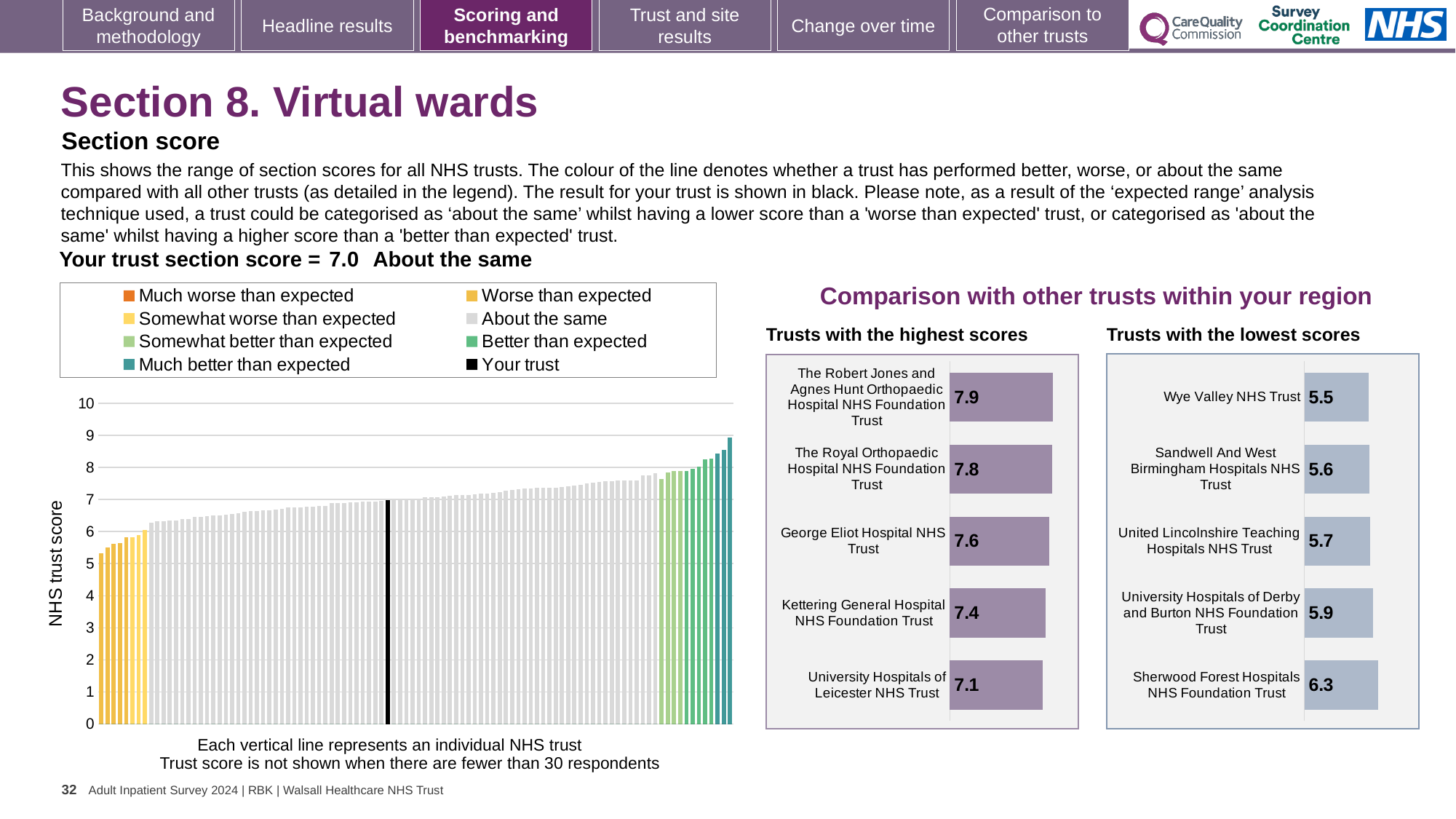
In the main NHS trust score chart on the left, do the values rise or fall from left to right? rise In the 'Trusts with the lowest scores' chart, which trust has the lowest score? Wye Valley NHS Trust In the 'Trusts with the highest scores' chart, what is the difference between the scores of The Robert Jones and Agnes Hunt Orthopaedic Hospital NHS Foundation Trust and University Hospitals of Leicester NHS Trust? 0.8 In the 'Trusts with the lowest scores' chart, which has the higher score: United Lincolnshire Teaching Hospitals NHS Trust or Sherwood Forest Hospitals NHS Foundation Trust? Sherwood Forest Hospitals NHS Foundation Trust In the main NHS trust score chart on the left, what is the section score for your trust? 7.0 How many entries does the legend of the main NHS trust score chart on the left list? 8 In the main NHS trust score chart on the left, is the value of the tallest bar greater or less than 8? greater What kind of chart is the main NHS trust score chart on the left? bar chart In the 'Trusts with the highest scores' chart, which trust has the highest score? The Robert Jones and Agnes Hunt Orthopaedic Hospital NHS Foundation Trust In the 'Trusts with the lowest scores' chart, what is the score for Sandwell And West Birmingham Hospitals NHS Trust? 5.6 In the 'Trusts with the highest scores' chart, what is the score for George Eliot Hospital NHS Trust? 7.6 In the 'Trusts with the highest scores' chart, how many trusts are shown? 5